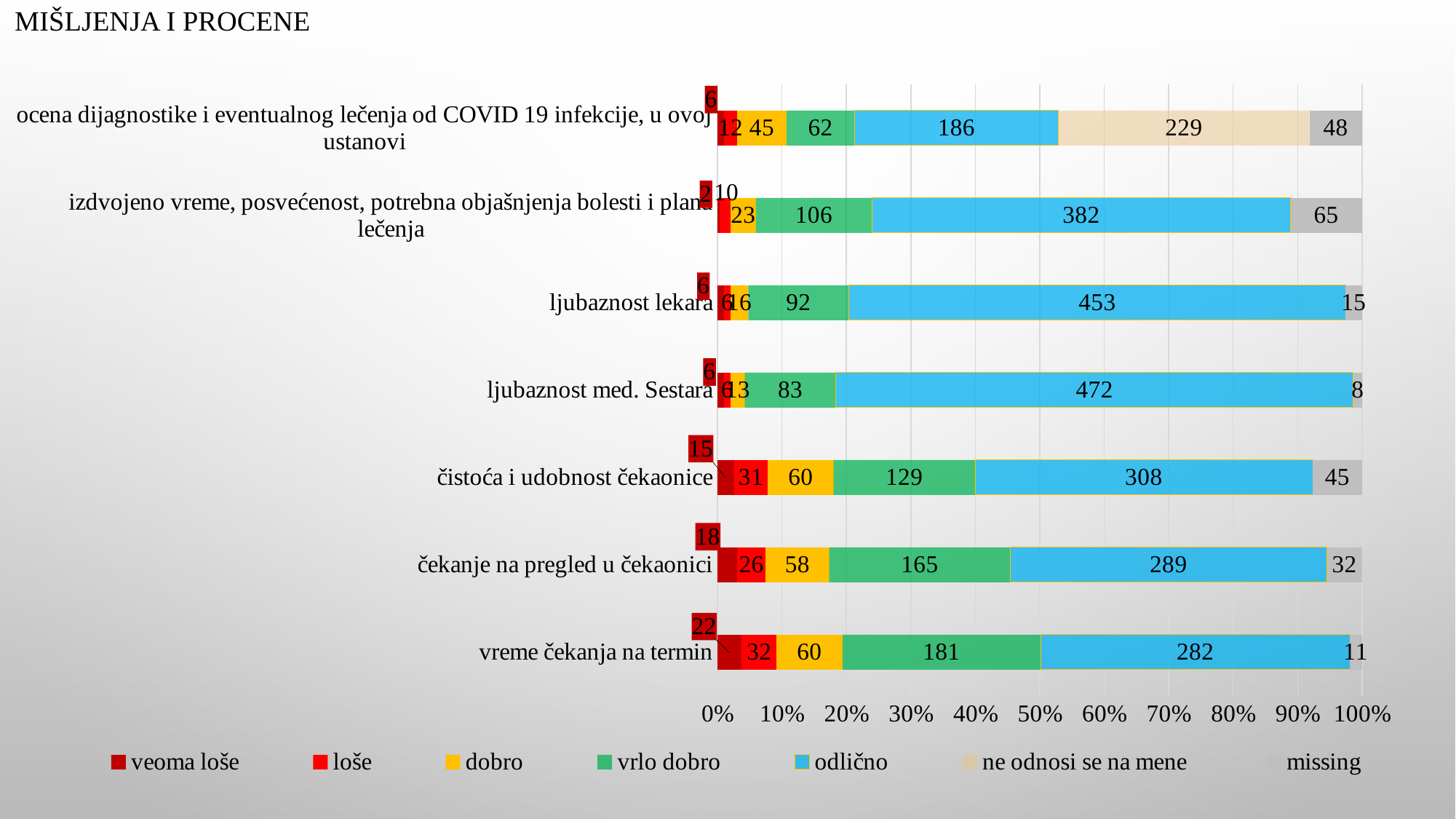
How many series does the legend list? 7 How many categories are plotted on the chart? 7 What is the 'odlično' value for 'ljubaznost med. Sestara'? 472 What kind of chart is shown on the slide? stacked bar chart Which is larger: the 'vrlo dobro' value for 'vreme čekanja na termin' or for 'čistoća i udobnost čekaonice'? vreme čekanja na termin What is the 'vrlo dobro' value for 'čekanje na pregled u čekaonici'? 165 Which category has the highest 'odlično' value? ljubaznost med. Sestara Which legend entry is shown in green? vrlo dobro What is the 'missing' value for 'izdvojeno vreme, posvećenost, potrebna objašnjenja bolesti i plana lečenja'? 65 Which category has the highest 'veoma loše' value? vreme čekanja na termin What is the 'ne odnosi se na mene' value for 'ocena dijagnostike i eventualnog lečenja od COVID 19 infekcije, u ovoj ustanovi'? 229 What is the difference between the 'odlično' values for 'čistoća i udobnost čekaonice' and 'čekanje na pregled u čekaonici'? 19